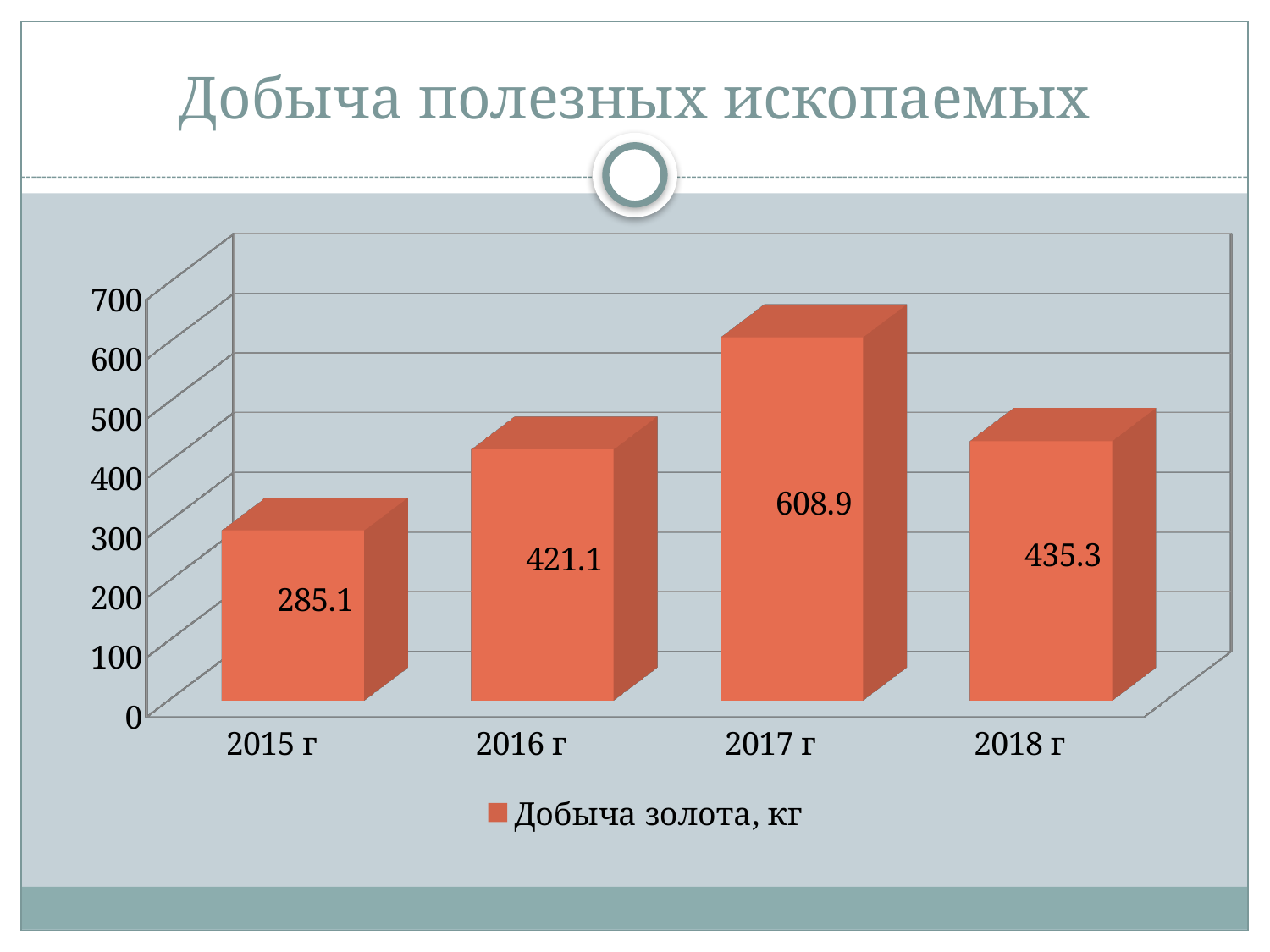
What is the value for 2017 г? 608.9 What is the difference between the values for 2017 г and 2016 г? 187.8 What is the legend entry of the series shown? Добыча золота, кг Is the value for 2016 г greater or less than 400? greater What kind of chart is shown on the slide? bar chart What is the value for 2018 г? 435.3 Which year has the lowest value? 2015 г What is the value for 2015 г? 285.1 Which year has the highest value? 2017 г How many series does the legend list? 1 Which is larger, the value for 2016 г or the value for 2018 г? 2018 г How many years are shown on the x axis? 4